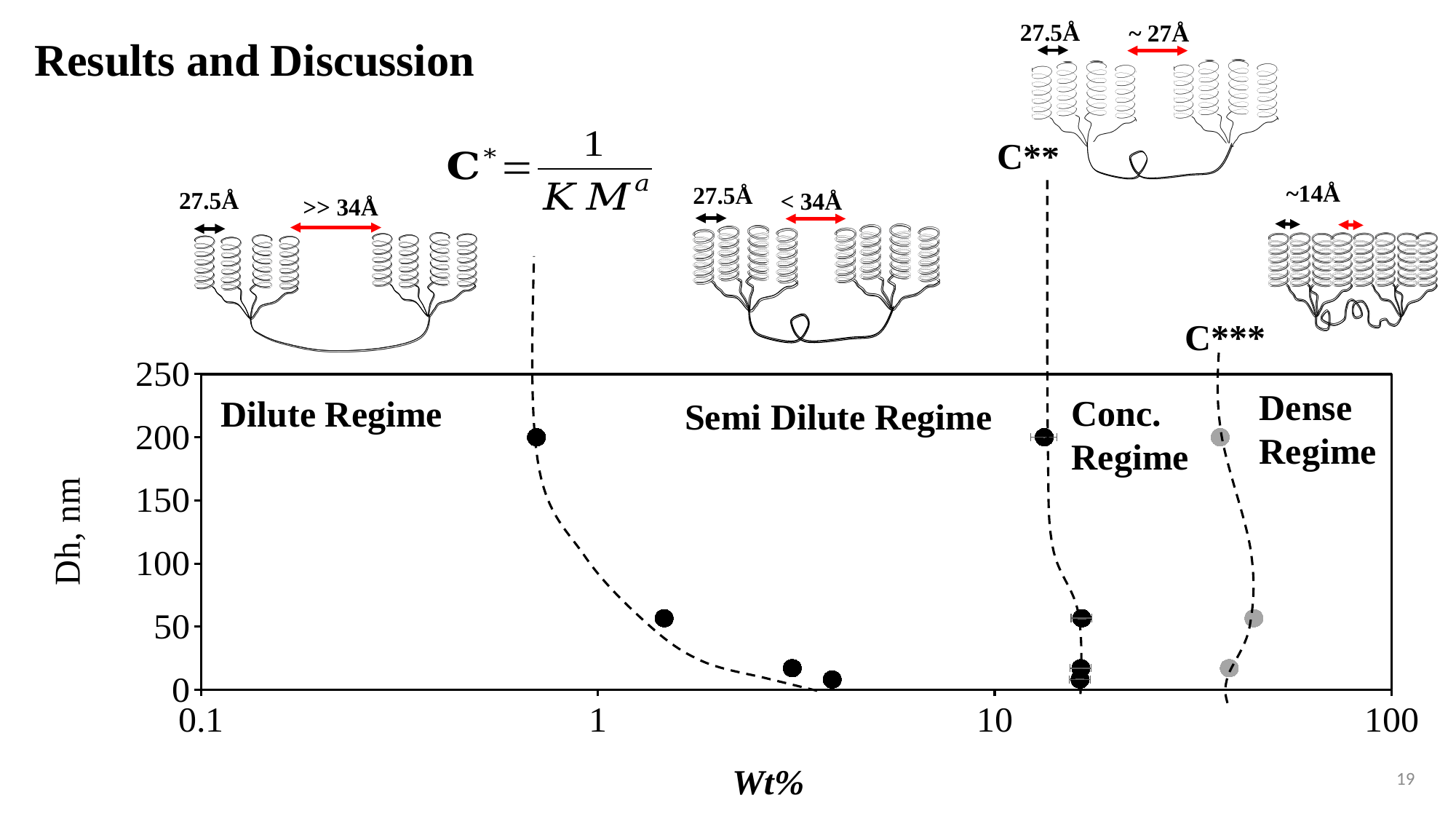
What kind of chart is shown on the slide? scatter plot Is the Dh value of the data point near 4 Wt% greater or less than 50? less Which has the larger Dh: the data point near 0.7 Wt% or the data point near 1.4 Wt%? the point near 0.7 Wt% What is the label of the x axis of the chart? Wt% What is the highest value shown on the y axis? 250 What is the lowest value shown on the x axis? 0.1 Is the Dh value of the leftmost data point (near 0.7 Wt%) greater or less than 150? greater Which regime is labelled at the far left of the plot? Dilute Regime Which regime is labelled at the far right of the plot? Dense Regime What is the label of the y axis of the chart? Dh, nm How many regimes are labelled inside the plot area? 4